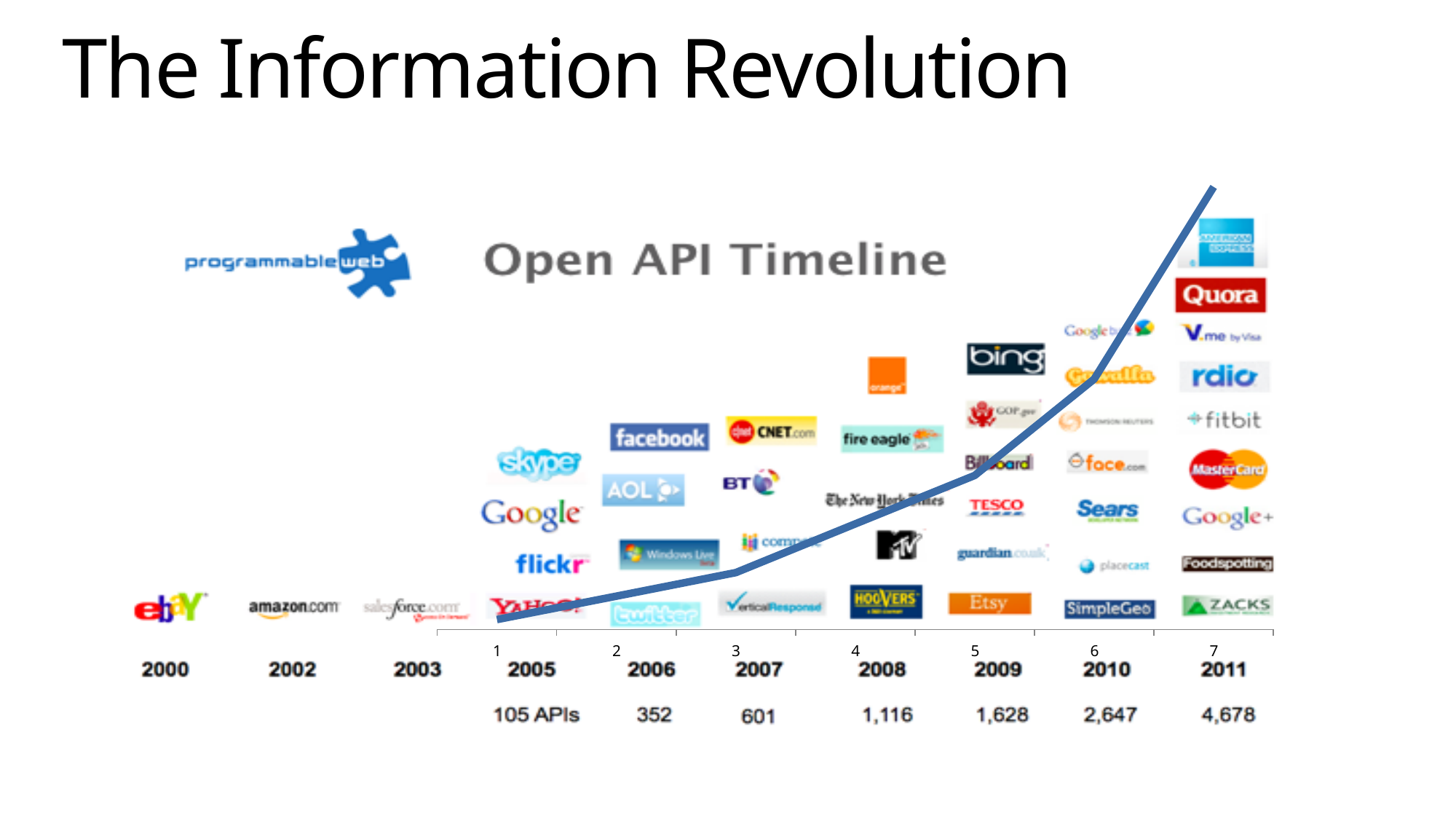
What is the number of APIs shown for 2008? 1,116 What kind of chart is overlaid on the Open API Timeline image? line chart What is the title printed on the timeline image? Open API Timeline What is the difference in the number of APIs between 2009 and 2008? 512 Which year has the lowest number of APIs? 2005 How many data points does the line chart have? 7 What is the number of APIs shown for 2011? 4,678 Which year has more APIs, 2007 or 2009? 2009 What is the difference in the number of APIs between 2011 and 2010? 2,031 How many APIs are listed for 2005? 105 APIs Do the values on the line chart rise or fall from 2005 to 2011? rise Which year has the highest number of APIs? 2011